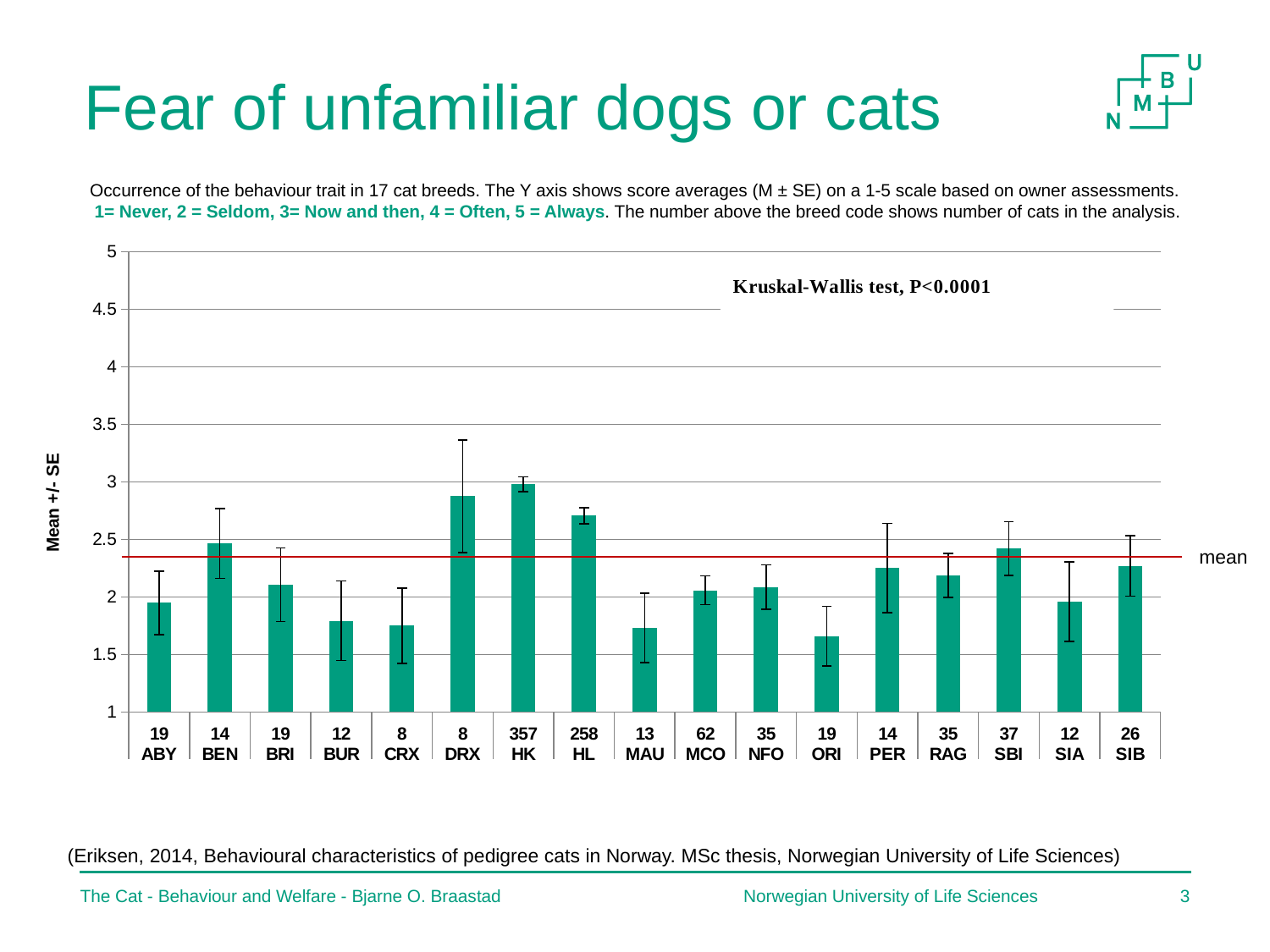
What statistical test and p-value are stated on the chart? Kruskal-Wallis test, P<0.0001 What is the label of the y axis of the chart? Mean +/- SE Is the mean score for HK greater or less than 2.5? greater How many cat breeds are shown on the x axis of the chart? 17 What kind of chart is shown on the slide? bar chart How many cats were included in the analysis for the HK breed, according to the number above the breed code? 357 Which breed has the highest mean score for fear of unfamiliar dogs or cats? HK Which breed has the larger mean score, BEN or BUR? BEN Is the mean score for HL greater or less than 2.5? greater Is the mean score for MAU greater or less than 2? less Which breed has the larger mean score, HL or MCO? HL